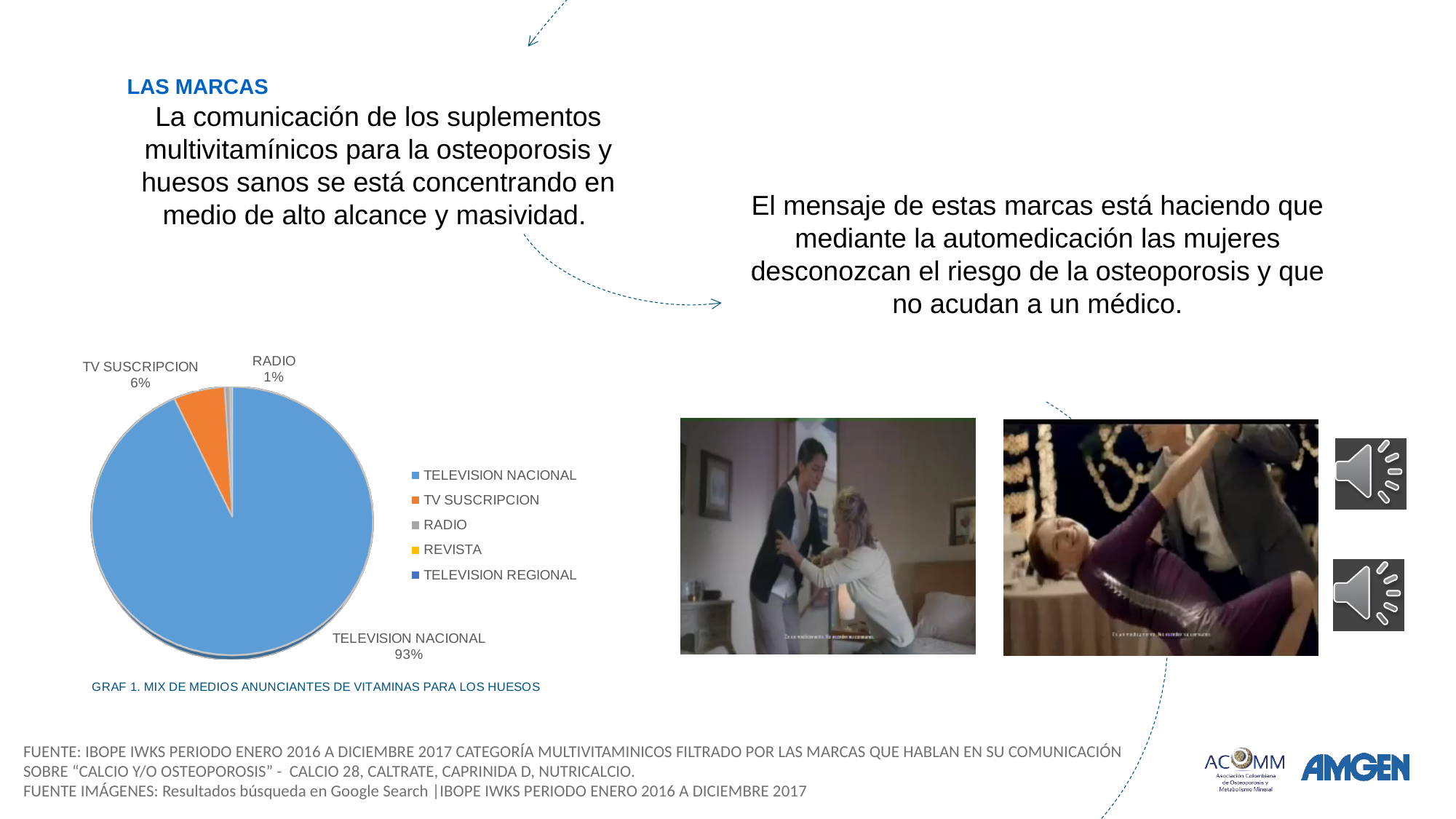
What share of the pie does TELEVISION NACIONAL represent? 93% Which colour represents TV SUSCRIPCION in the pie chart? Orange What is the difference in percentage points between TV SUSCRIPCION and RADIO? 5 What is the difference in percentage points between TELEVISION NACIONAL and TV SUSCRIPCION? 87 Which category has the largest slice of the pie? TELEVISION NACIONAL How many categories does the legend of the pie chart list? 5 What is the value shown for RADIO? 1% What is the caption/title given below the pie chart? GRAF 1. MIX DE MEDIOS ANUNCIANTES DE VITAMINAS PARA LOS HUESOS What kind of chart is shown on the slide? Pie chart Which is larger, TV SUSCRIPCION or RADIO? TV SUSCRIPCION What is the value shown for TV SUSCRIPCION? 6%